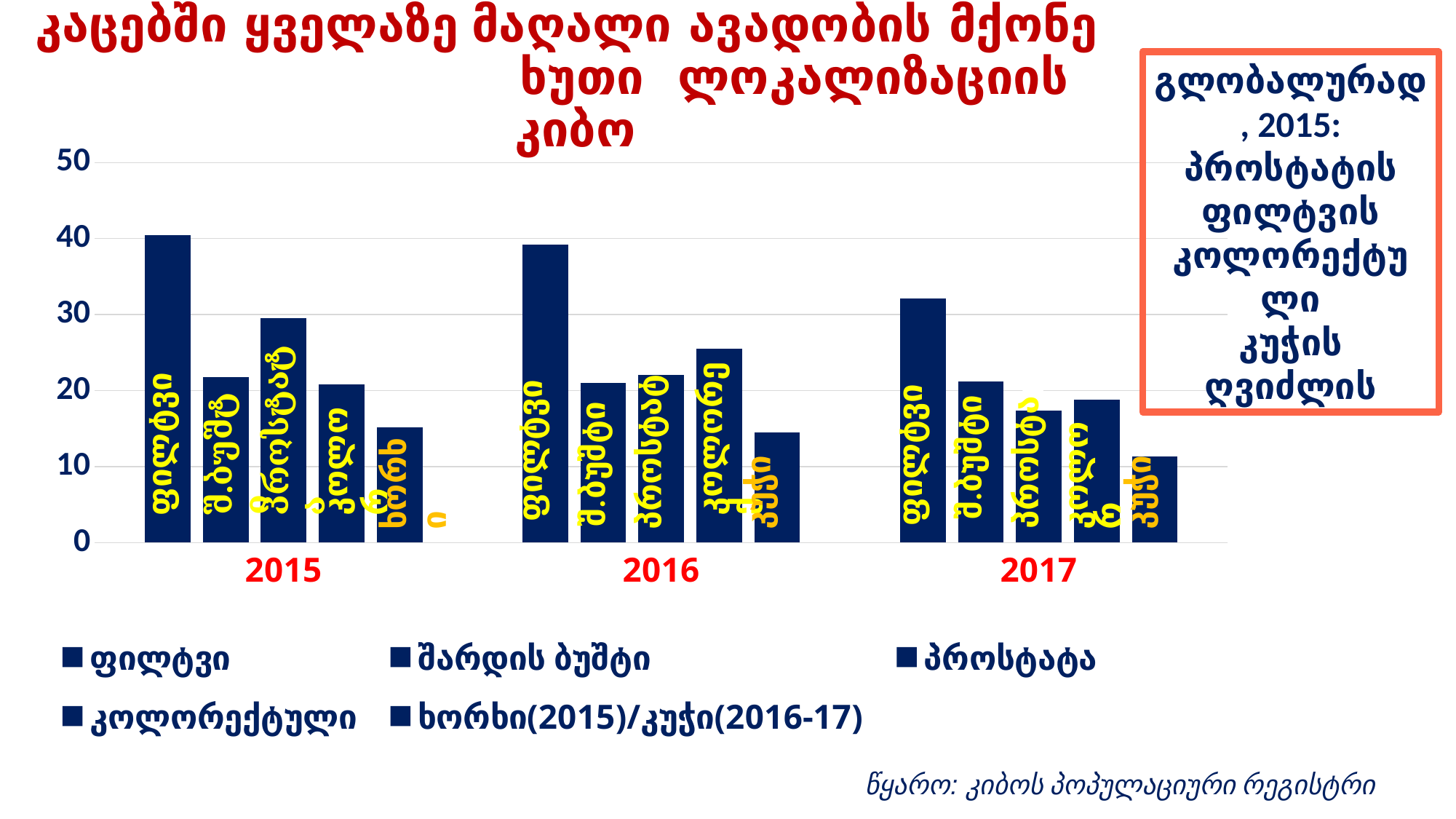
Which cancer site has the highest bar in the 2017 group? ფილტვი Does the value for ფილტვი rise or fall from 2015 to 2017? fall Is the value for კოლორექტული in 2016 greater or less than 20? greater Which cancer site has the lowest bar in the 2015 group? ხორხი Which cancer site has the highest bar in the 2015 group? ფილტვი What kind of chart is shown on the slide? bar chart Which is larger in 2016: the bar for შარდის ბუშტი or the bar for კოლორექტული? კოლორექტული What is the label of the last series in the chart legend? ხორხი(2015)/კუჭი(2016-17) Is the value for პროსტატა in 2015 greater or less than 20? greater How many series does the chart legend list? 5 How many year groups are shown on the x axis of the chart? 3 Is the value for ფილტვი in 2015 greater or less than 30? greater